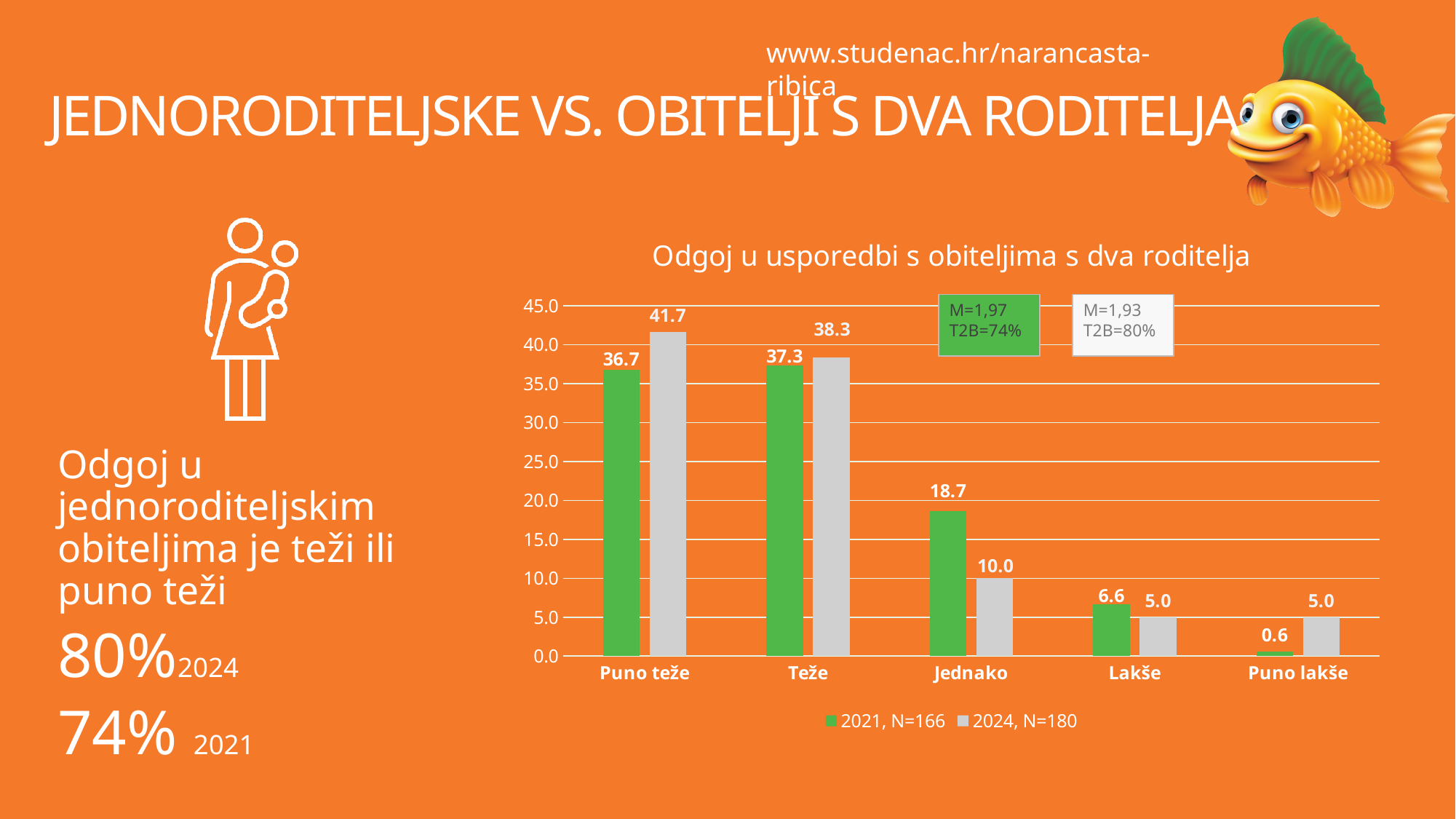
What is the value for 'Puno teže' in the 2021, N=166 series? 36.7 What is the title of the chart? Odgoj u usporedbi s obiteljima s dva roditelja What is the value for 'Jednako' in the 2024, N=180 series? 10.0 Which category has the lowest value in the 2021, N=166 series? Puno lakše What is the difference between the 2024 and 2021 values for 'Jednako'? 8.7 Which is larger for 'Teže': the 2021, N=166 value or the 2024, N=180 value? 2024, N=180 Which category has the highest value in the 2024, N=180 series? Puno teže What kind of chart is shown on the slide? Bar chart How many series does the legend list? 2 What is the value for 'Puno lakše' in the 2021, N=166 series? 0.6 What is the value for 'Puno teže' in the 2024, N=180 series? 41.7 How many categories are shown on the x axis? 5